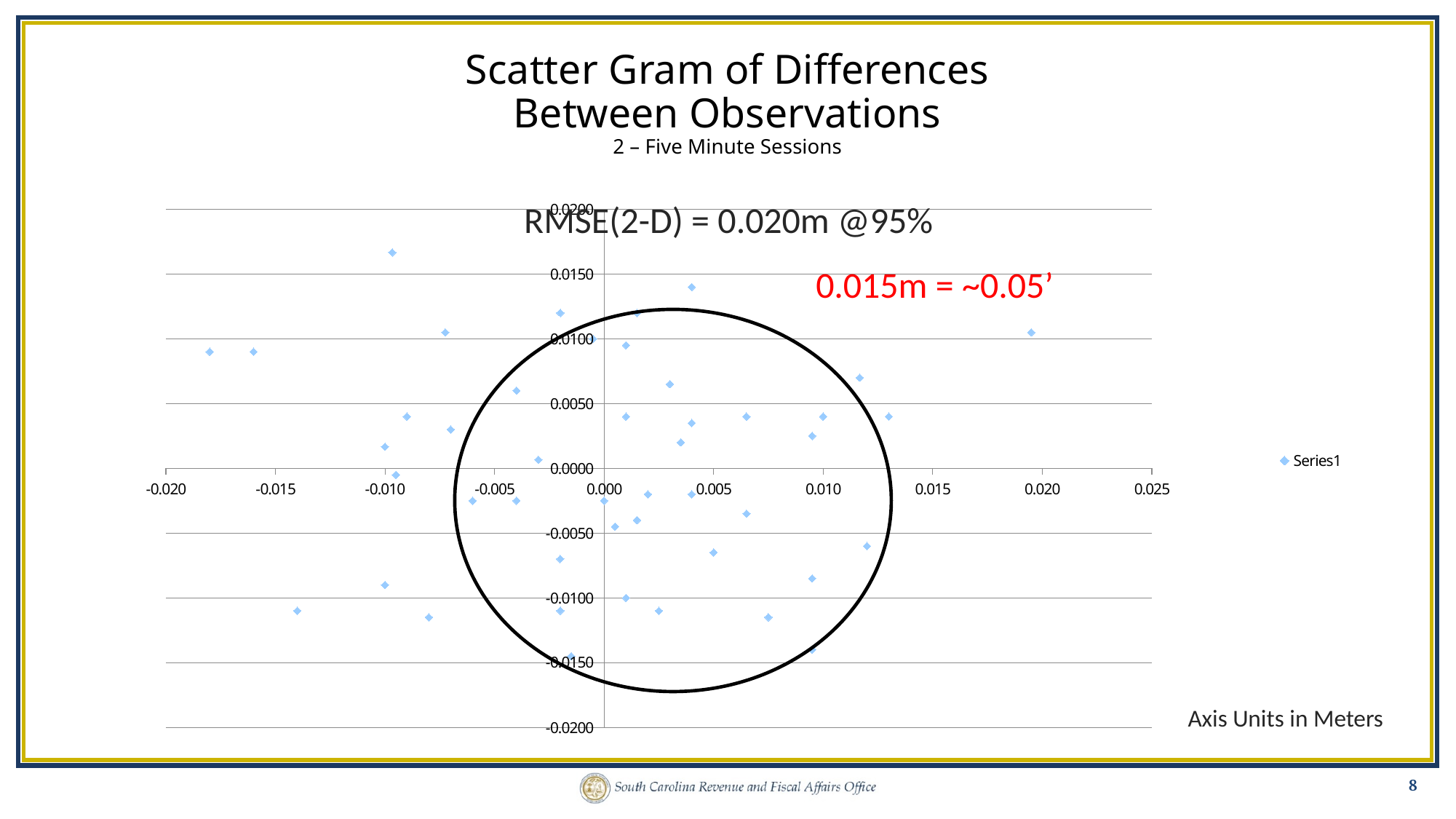
How many series does the legend list? 1 Is the x value of the leftmost point greater or less than -0.015? less What is the name of the series shown in the legend? Series1 Is the x value of the rightmost point greater or less than 0.015? greater What kind of chart is shown on the slide? Scatter chart Is the y value of the lowest point greater or less than -0.0100? less What is the RMSE(2-D) value stated on the chart? 0.020m @95%